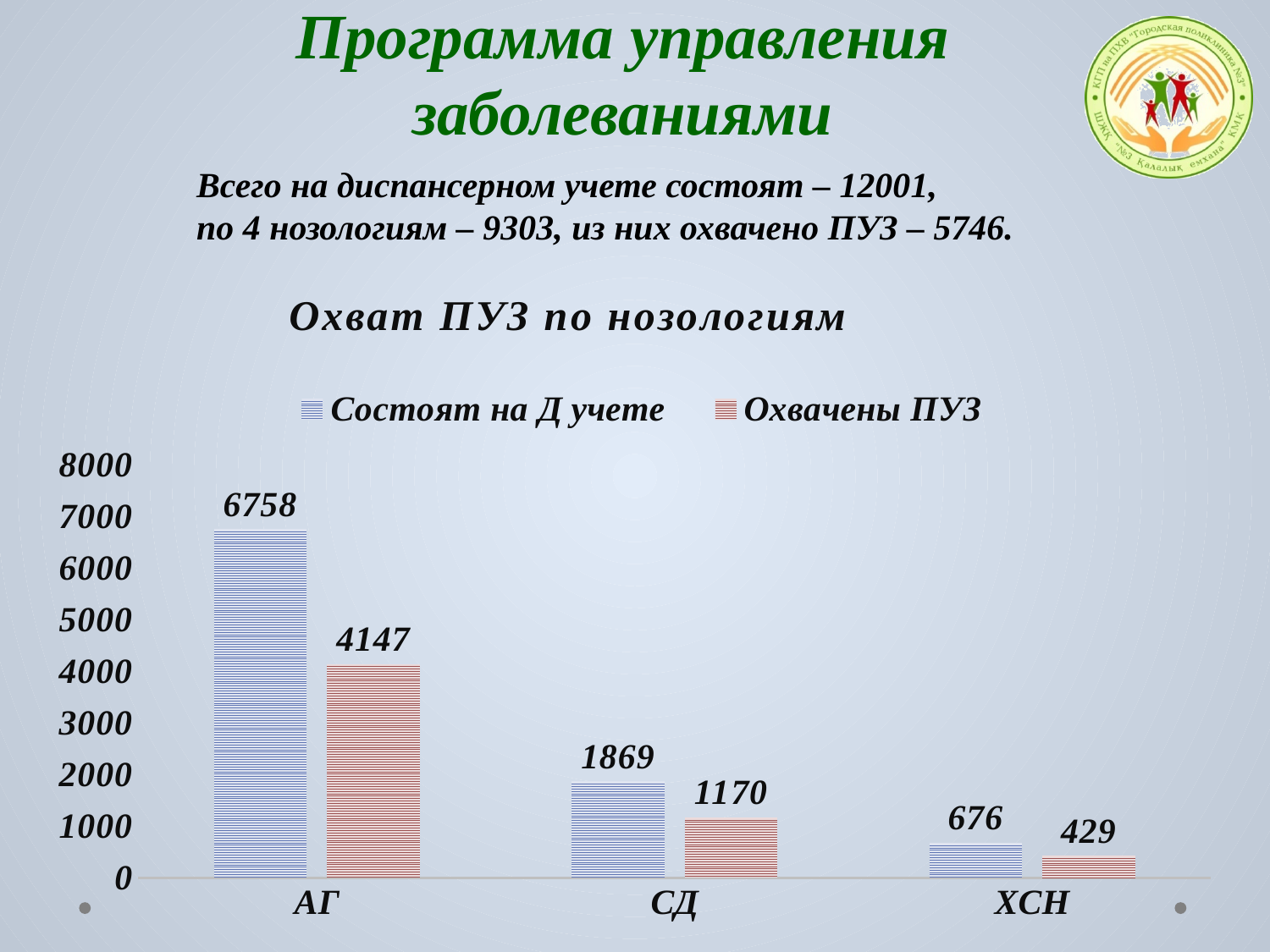
What kind of chart is shown on the slide? Bar chart What is the value for ХСН in the 'Состоят на Д учете' series? 676 Which category has the highest value in the 'Охвачены ПУЗ' series? АГ What is the difference between 'Состоят на Д учете' and 'Охвачены ПУЗ' for ХСН? 247 Which is larger: 'Охвачены ПУЗ' for АГ or 'Состоят на Д учете' for СД? Охвачены ПУЗ for АГ How many categories are shown on the x axis? 3 How many series does the legend list? 2 What is the difference between 'Состоят на Д учете' and 'Охвачены ПУЗ' for АГ? 2611 What is the value for АГ in the 'Состоят на Д учете' series? 6758 What is the value for СД in the 'Охвачены ПУЗ' series? 1170 What is the title of the chart? Охват ПУЗ по нозологиям Which category has the lowest value in the 'Состоят на Д учете' series? ХСН